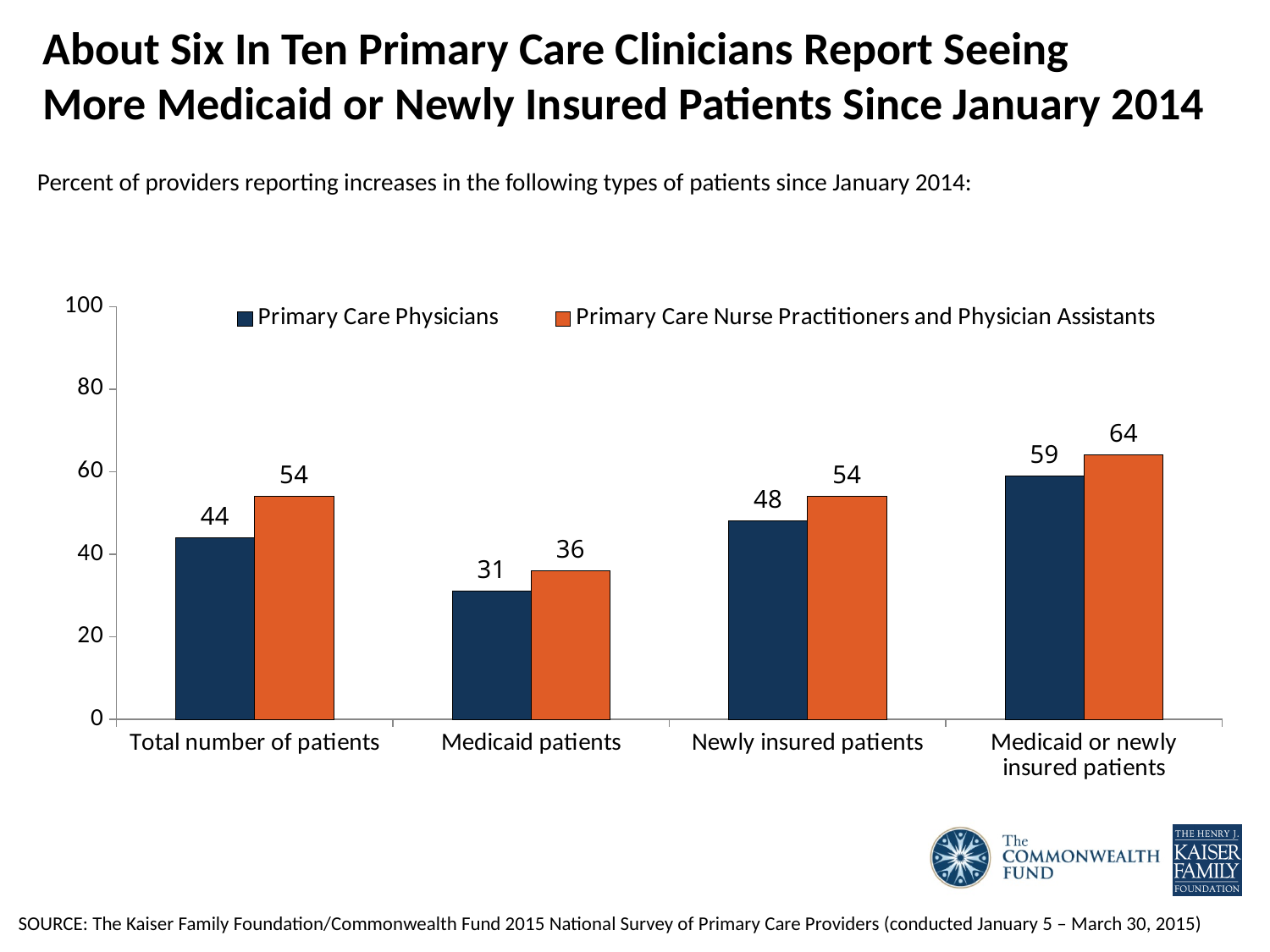
What percent of Primary Care Physicians report an increase in Medicaid patients? 31 Is the value for Primary Care Physicians for Medicaid or newly insured patients greater or less than 40? greater Which category has the highest value for Primary Care Physicians? Medicaid or newly insured patients How many categories are shown on the x axis? 4 Which category has the lowest value for Primary Care Nurse Practitioners and Physician Assistants? Medicaid patients For Medicaid patients, which series has the larger value: Primary Care Physicians or Primary Care Nurse Practitioners and Physician Assistants? Primary Care Nurse Practitioners and Physician Assistants How many series does the legend list? 2 What percent of Primary Care Nurse Practitioners and Physician Assistants report an increase in Medicaid or newly insured patients? 64 What colour are the bars for Primary Care Nurse Practitioners and Physician Assistants? orange What is the value for Primary Care Physicians for Newly insured patients? 48 What is the difference between the Primary Care Nurse Practitioners and Physician Assistants value and the Primary Care Physicians value for Total number of patients? 10 What kind of chart is shown on the slide? bar chart